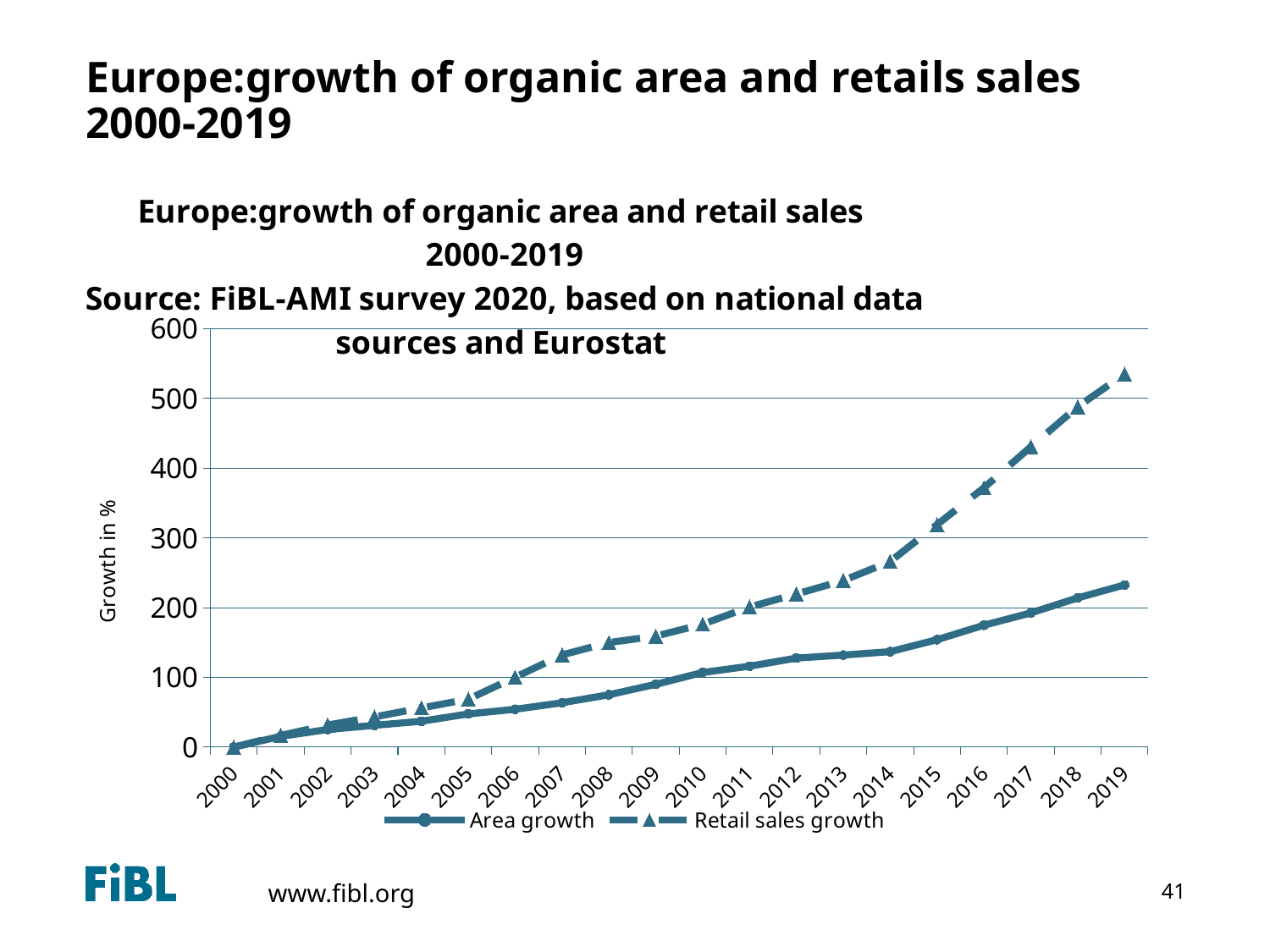
In which year is Retail sales growth highest? 2019 Is the Area growth value for 2005 greater or less than 100? less How many years are plotted along the x axis? 20 How many series does the legend list? 2 In which year is Area growth lowest? 2000 Do the Retail sales growth values rise or fall from 2000 to 2019? rise Is the Retail sales growth value for 2010 greater or less than 200? less Is the Area growth value for 2019 greater or less than 200? greater Which series has the larger value in 2019, Area growth or Retail sales growth? Retail sales growth What kind of chart is shown on the slide? line chart What is the label of the y axis? Growth in %